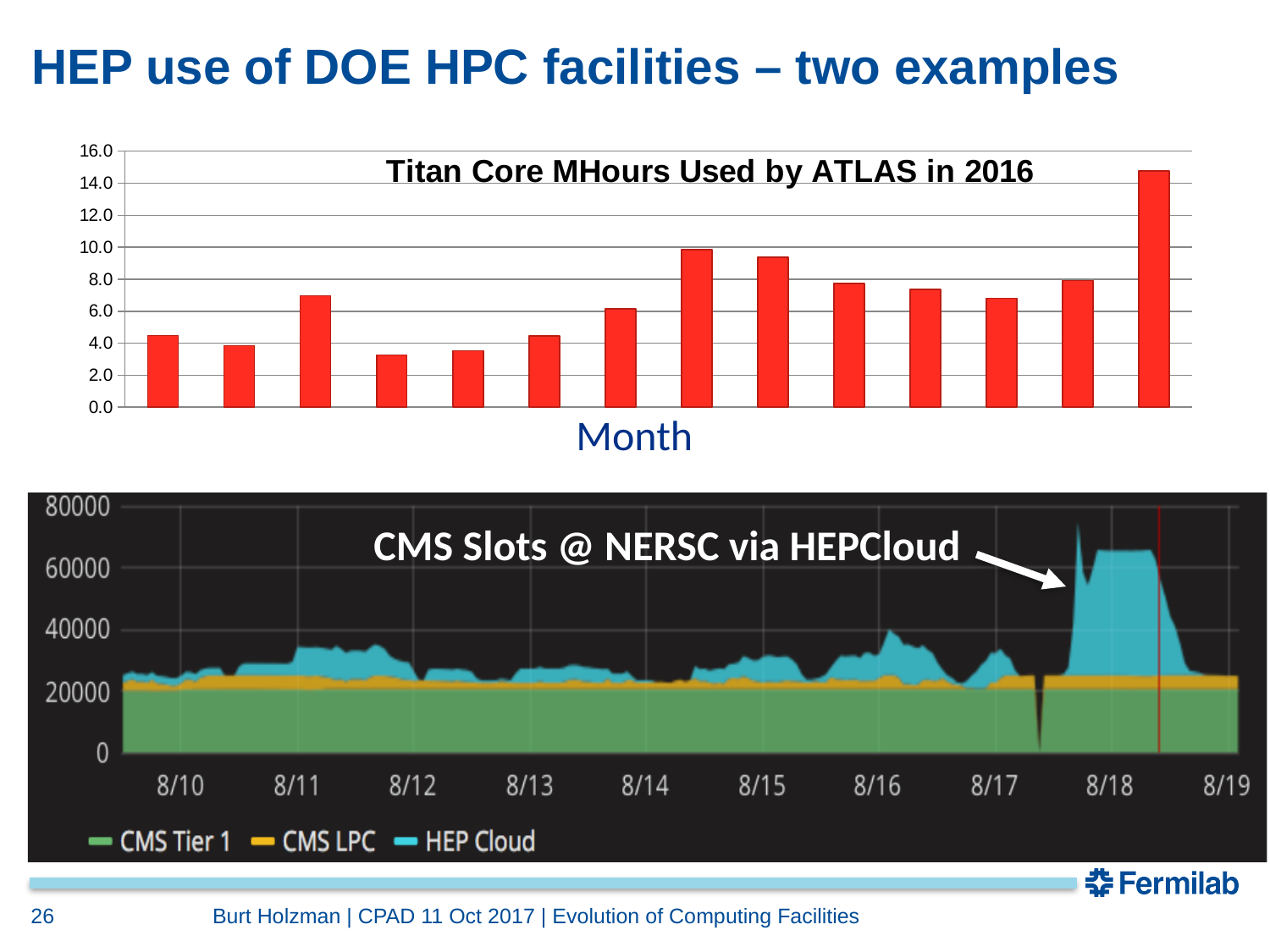
How many bars are plotted in the top chart, "Titan Core MHours Used by ATLAS in 2016"? 14 In the top chart, "Titan Core MHours Used by ATLAS in 2016", is the value of the shortest bar greater or less than 4.0? less What is the maximum value shown on the y axis of the top chart, "Titan Core MHours Used by ATLAS in 2016"? 16.0 What kind of chart is the top chart titled "Titan Core MHours Used by ATLAS in 2016"? bar chart In the bottom chart, "CMS Slots @ NERSC via HEPCloud", which series is shown in green according to the legend? CMS Tier 1 How many series does the legend of the bottom chart, "CMS Slots @ NERSC via HEPCloud", list? 3 What kind of chart is the bottom chart titled "CMS Slots @ NERSC via HEPCloud"? stacked area chart In the top chart, "Titan Core MHours Used by ATLAS in 2016", which bar is the highest: the first bar or the last bar? the last bar How many date labels are shown on the x axis of the bottom chart, "CMS Slots @ NERSC via HEPCloud"? 10 In the top chart, "Titan Core MHours Used by ATLAS in 2016", is the value of the first bar greater or less than 6.0? less In the bottom chart, "CMS Slots @ NERSC via HEPCloud", is the peak total value near 8/18 greater or less than 60000? greater